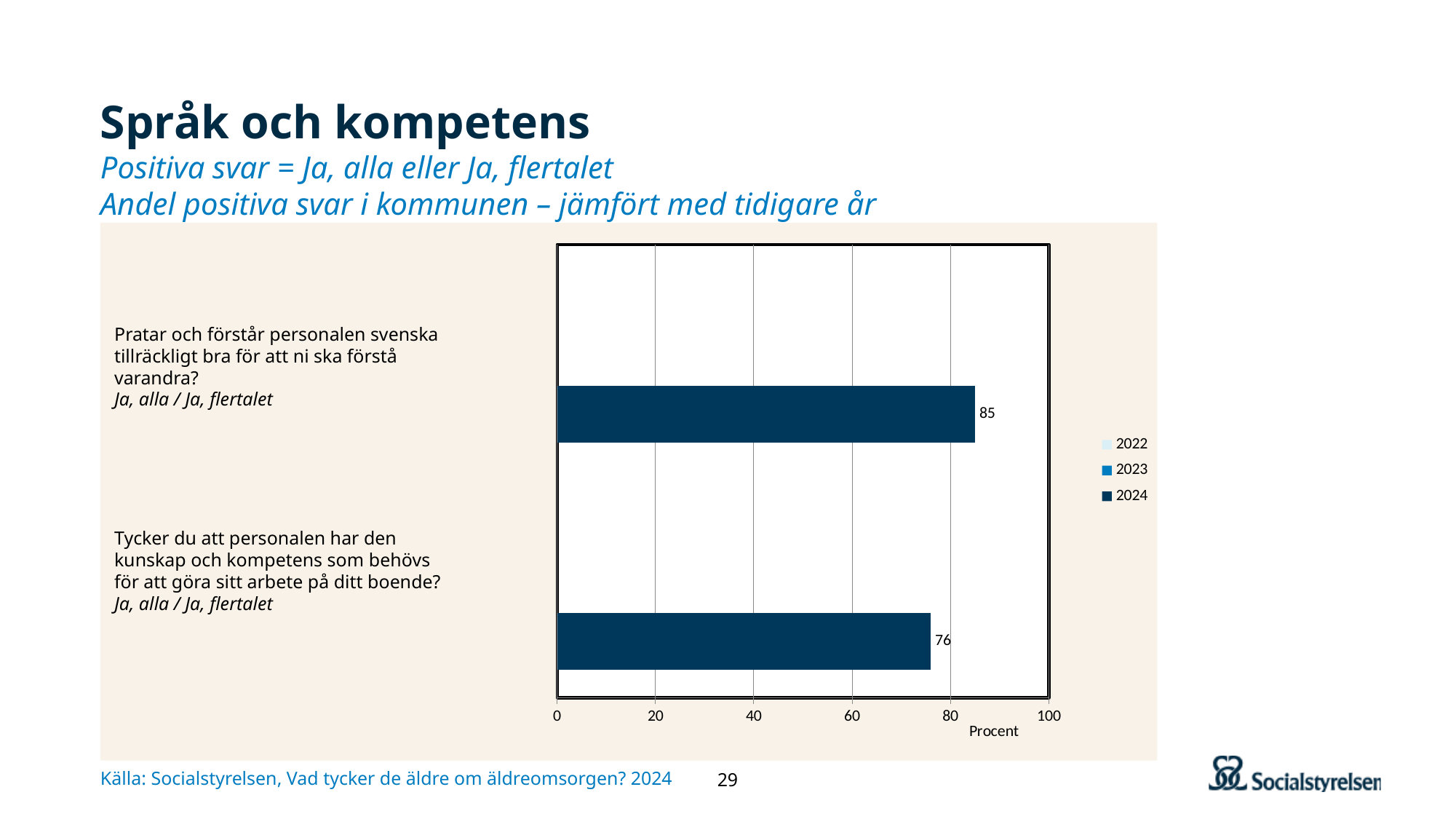
Is the 2024 value for the question about staff speaking and understanding Swedish larger than the 2024 value for the question about staff knowledge and competence? Yes Which question has the lower 2024 value? Tycker du att personalen har den kunskap och kompetens som behövs för att göra sitt arbete på ditt boende? How many series does the legend list? 3 What is the label of the horizontal axis? Procent What is the 2024 value for the question "Tycker du att personalen har den kunskap och kompetens som behövs för att göra sitt arbete på ditt boende?"? 76 How many questions (categories) are shown in the chart? 2 Which question has the higher 2024 value? Pratar och förstår personalen svenska tillräckligt bra för att ni ska förstå varandra? What type of chart is shown on the slide? Bar chart Is the 2024 value for the question about staff knowledge and competence greater or less than 80? less Is the 2024 value for the question about staff speaking Swedish greater or less than 80? greater What is the 2024 value for the question "Pratar och förstår personalen svenska tillräckligt bra för att ni ska förstå varandra?"? 85 What is the difference between the 2024 values for the two questions? 9